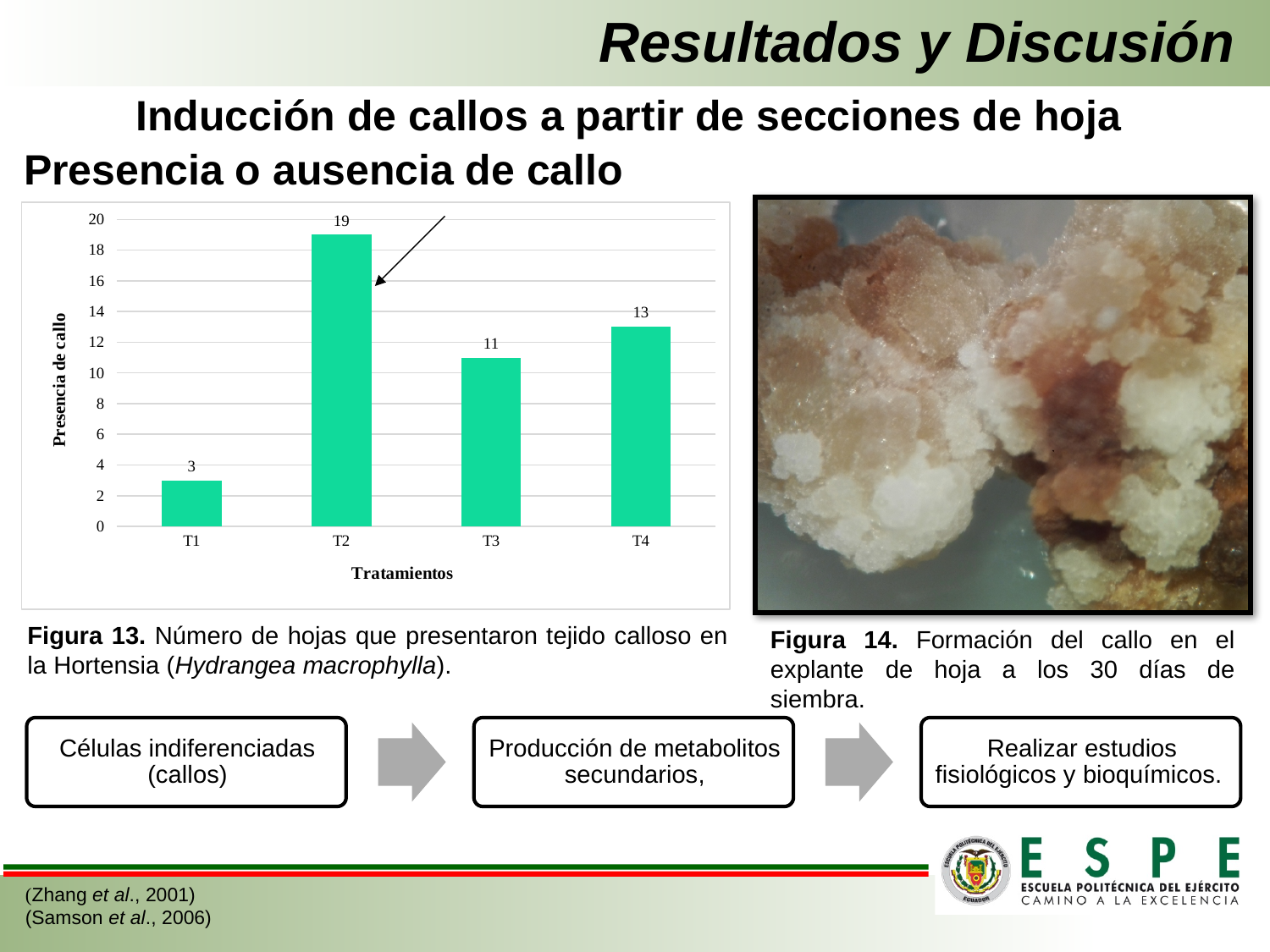
Which treatment has the lowest value in the bar chart? T1 Which is larger, the value for T3 or the value for T4? T4 How many treatments are shown on the x axis of the bar chart? 4 Which treatment has the highest value in the bar chart? T2 What kind of chart is shown on the slide? Bar chart What is the value for T2 in the bar chart? 19 What is the value for T4 in the bar chart? 13 What is the value for T3 in the bar chart? 11 What is the difference between the values for T4 and T3? 2 What is the label of the y axis of the bar chart? Presencia de callo What is the difference between the values for T2 and T1? 16 What is the value for T1 in the bar chart? 3